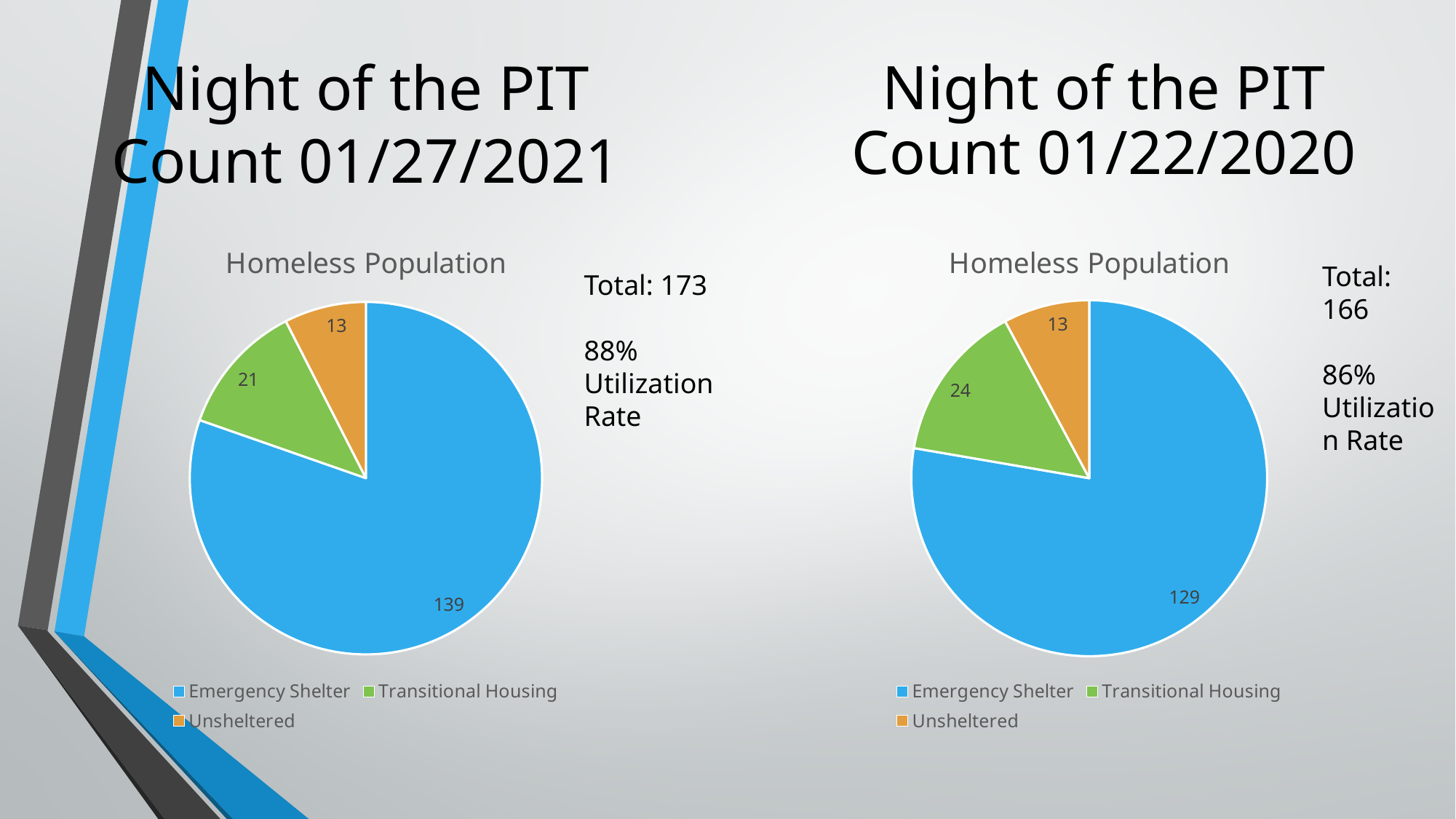
In the right pie chart (01/22/2020), what is the value for Transitional Housing? 24 What is the title of the left pie chart? Homeless Population In the left pie chart (01/27/2021), what is the value for Emergency Shelter? 139 Is the Transitional Housing value larger in the left chart (2021) or the right chart (2020)? right chart (2020) What is the difference between the Emergency Shelter value in the left chart (2021) and the Emergency Shelter value in the right chart (2020)? 10 In the left pie chart (01/27/2021), which category has the largest slice? Emergency Shelter How many categories does the legend of the left pie chart list? 3 In the right pie chart (01/22/2020), which category has the smallest slice? Unsheltered In the left pie chart (01/27/2021), what is the difference between Emergency Shelter and Transitional Housing? 118 In the left pie chart (01/27/2021), what is the value for Transitional Housing? 21 In the right pie chart (01/22/2020), what is the value for Unsheltered? 13 What type of chart is used on the right side of the slide (01/22/2020)? pie chart